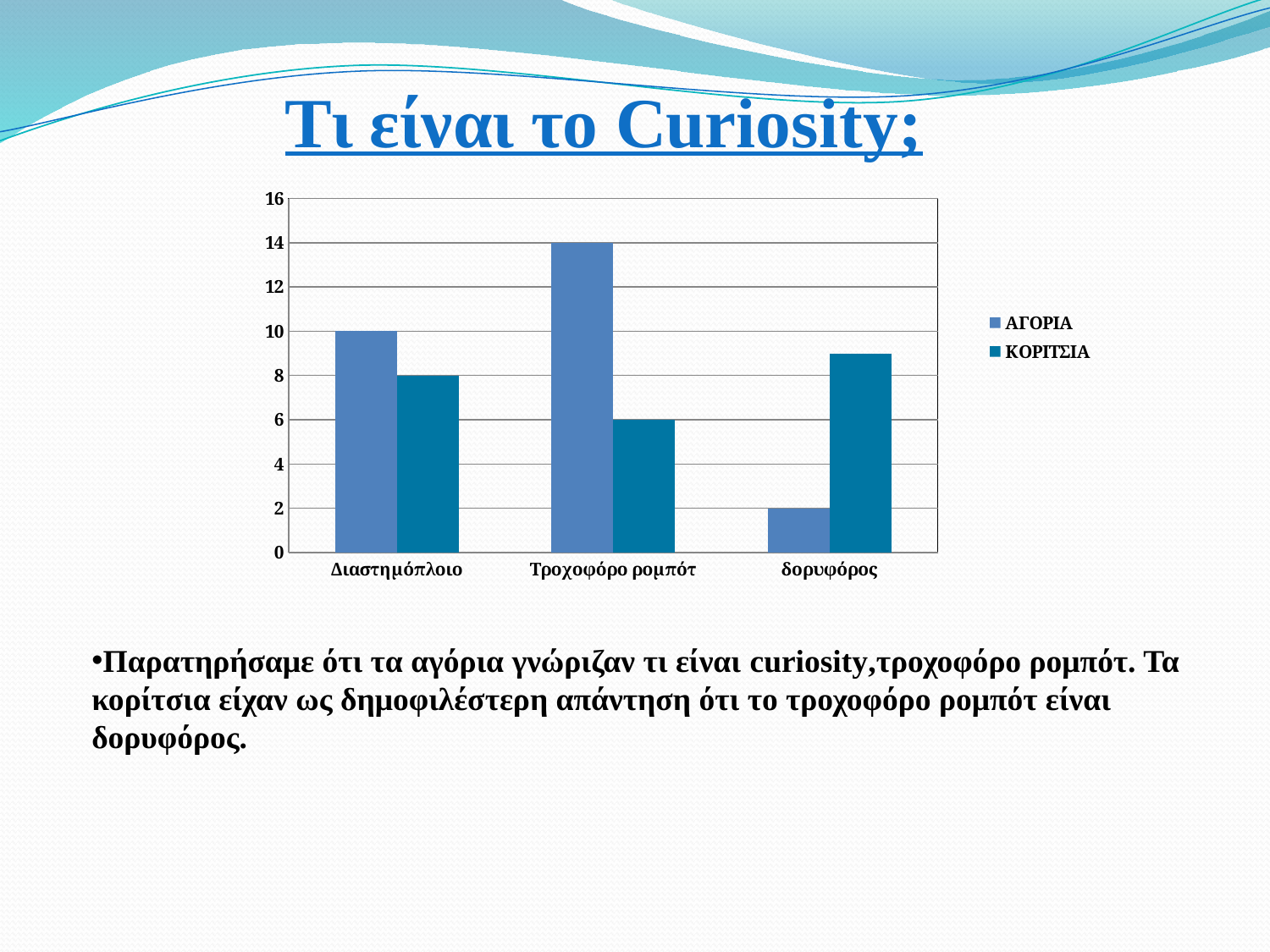
What is the value for ΑΓΟΡΙΑ in the Διαστημόπλοιο category? 10 What is the value for ΑΓΟΡΙΑ in the Τροχοφόρο ρομπότ category? 14 How many categories are shown on the x axis? 3 What is the value for ΑΓΟΡΙΑ in the δορυφόρος category? 2 Which category has the lowest value for ΚΟΡΙΤΣΙΑ? Τροχοφόρο ρομπότ What is the value for ΚΟΡΙΤΣΙΑ in the Τροχοφόρο ρομπότ category? 6 How many series does the legend list? 2 Which is larger in the δορυφόρος category, ΑΓΟΡΙΑ or ΚΟΡΙΤΣΙΑ? ΚΟΡΙΤΣΙΑ What kind of chart is shown on the slide? bar chart Which category has the highest value for ΑΓΟΡΙΑ? Τροχοφόρο ρομπότ Is the value for ΚΟΡΙΤΣΙΑ in the δορυφόρος category greater or less than 8? greater What is the difference between the ΑΓΟΡΙΑ and ΚΟΡΙΤΣΙΑ values in the Τροχοφόρο ρομπότ category? 8